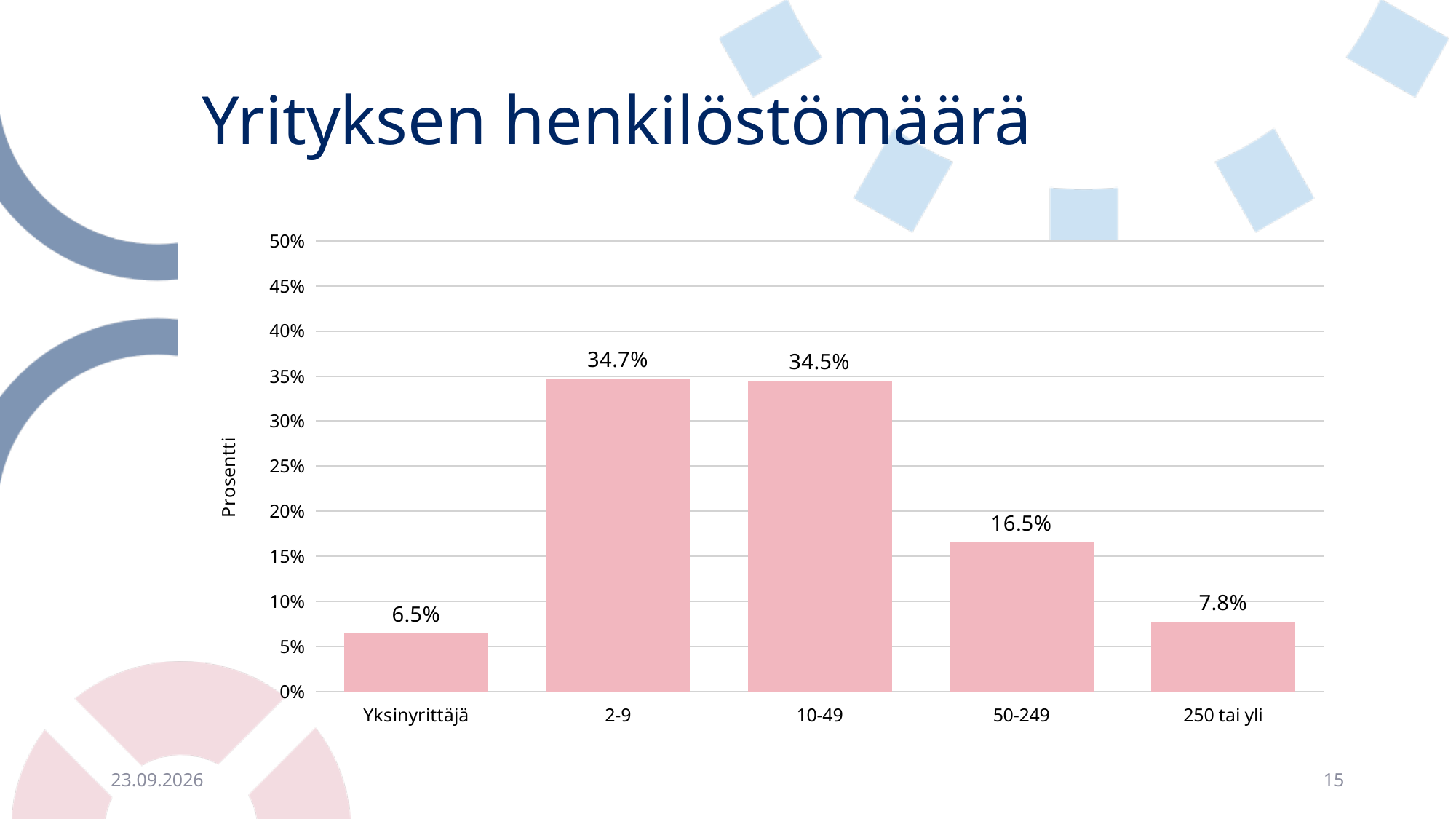
How many categories are shown on the x axis? 5 What kind of chart is shown on the slide? Bar chart What is the difference between the values for 2-9 and 50-249? 18.2% What is the value for Yksinyrittäjä? 6.5% What is the value for the 10-49 category? 34.5% What is the value for the 50-249 category? 16.5% What is the value for the 2-9 category? 34.7% Which is larger, the value for 50-249 or the value for 250 tai yli? 50-249 Which category has the lowest value? Yksinyrittäjä What is the difference between the values for 250 tai yli and Yksinyrittäjä? 1.3% What is the label of the y axis? Prosentti What is the value for the 250 tai yli category? 7.8%